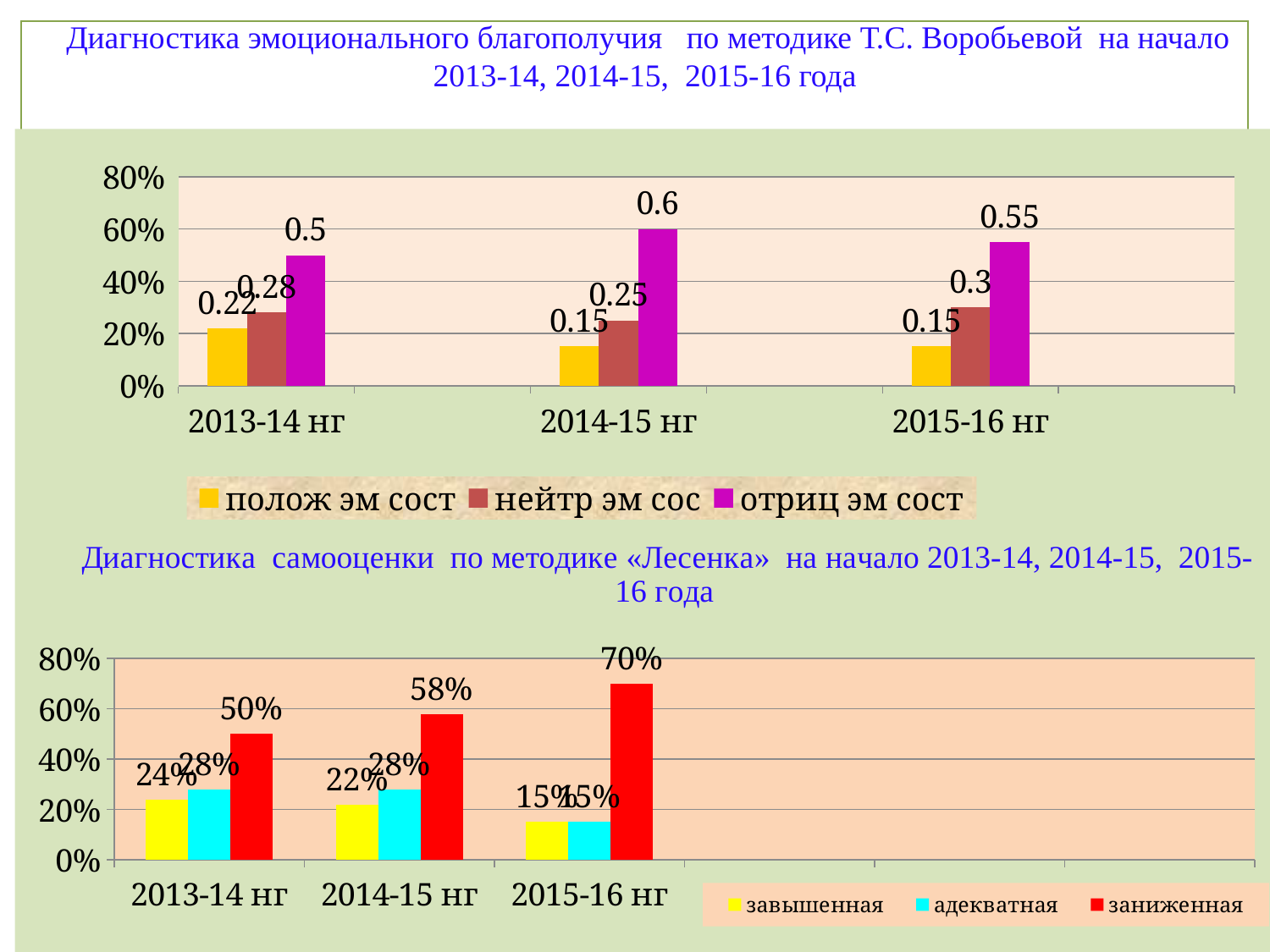
In the bottom chart, what is the difference between заниженная in 2015-16 нг and in 2013-14 нг? 20% In the top chart, what is the value for полож эм сост in 2013-14 нг? 0.22 In the top chart, how many series does the legend list? 3 In the top chart, which year has the highest value for отриц эм сост? 2014-15 нг In the top chart (Диагностика эмоционального благополучия), what is the value for отриц эм сост in 2014-15 нг? 0.6 In the top chart, what is the difference between нейтр эм сос in 2015-16 нг and in 2014-15 нг? 0.05 In the bottom chart, which year has the lowest value for адекватная? 2015-16 нг What kind of chart is the bottom chart? bar chart In the bottom chart (Диагностика самооценки), what is the value for заниженная in 2015-16 нг? 70% In the bottom chart, what is the value for завышенная in 2014-15 нг? 22% In the bottom chart, which is larger in 2013-14 нг: завышенная or адекватная? адекватная In the top chart, does the value for полож эм сост rise or fall from 2013-14 нг to 2015-16 нг? fall